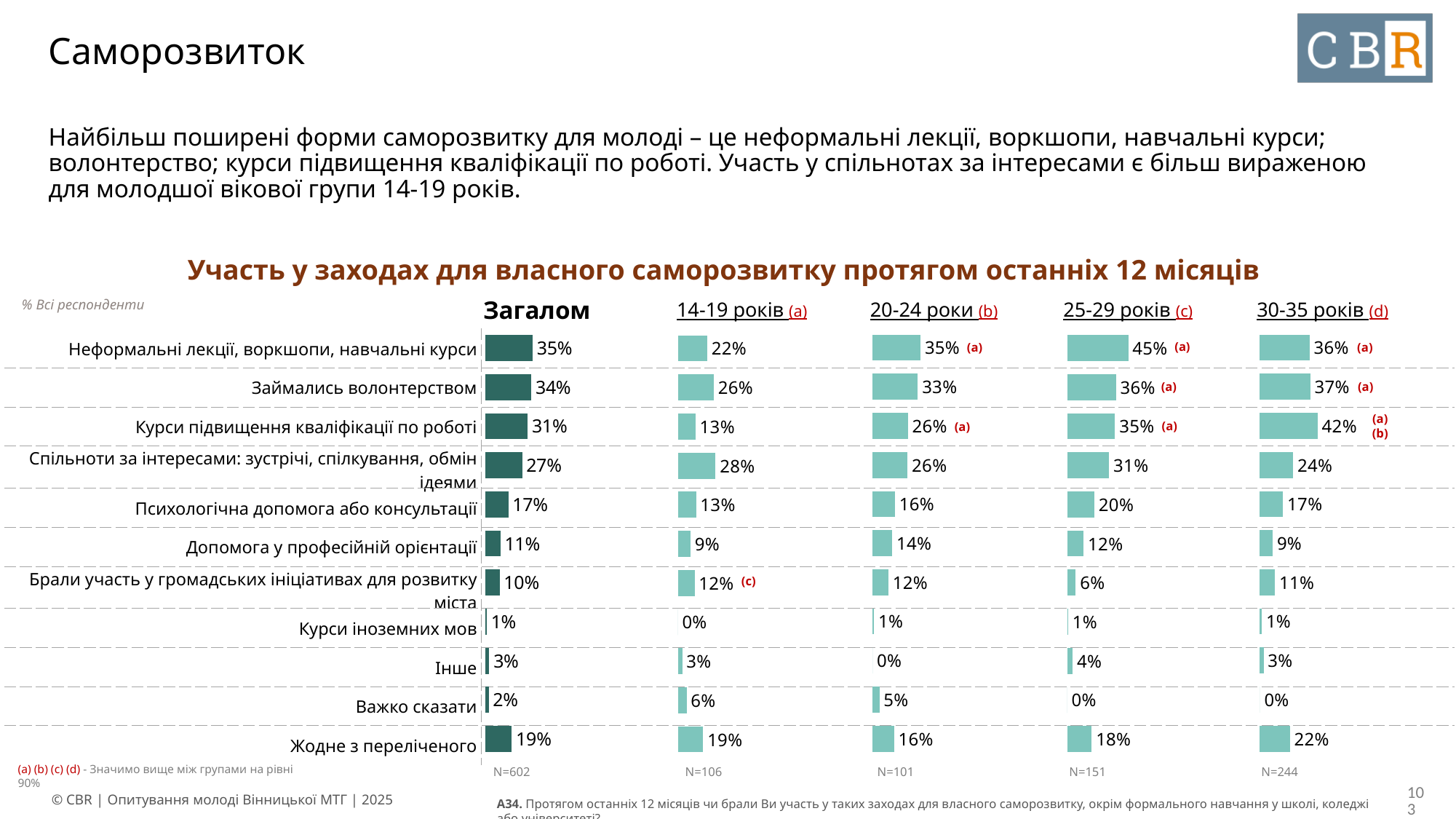
What is the title of the chart? Участь у заходах для власного саморозвитку протягом останніх 12 місяців Which category has the lowest value in the "Загалом" column? Курси іноземних мов What is the difference between the "25-29 років" and "14-19 років" values for "Неформальні лекції, воркшопи, навчальні курси"? 23% What is the sample size (N) shown for the "Загалом" column? N=602 Which category has the highest value in the "Загалом" column? Неформальні лекції, воркшопи, навчальні курси What kind of chart is shown on the slide? Bar chart How many columns (groups) of bars are shown in the chart? 5 What is the value for "Курси підвищення кваліфікації по роботі" in the "30-35 років" column? 42% What is the value for "Неформальні лекції, воркшопи, навчальні курси" in the "Загалом" column? 35% Which is larger for "Спільноти за інтересами: зустрічі, спілкування, обмін ідеями": the "14-19 років" value or the "30-35 років" value? 14-19 років How many categories (rows) are shown in the chart? 11 What is the value for "Психологічна допомога або консультації" in the "25-29 років" column? 20%